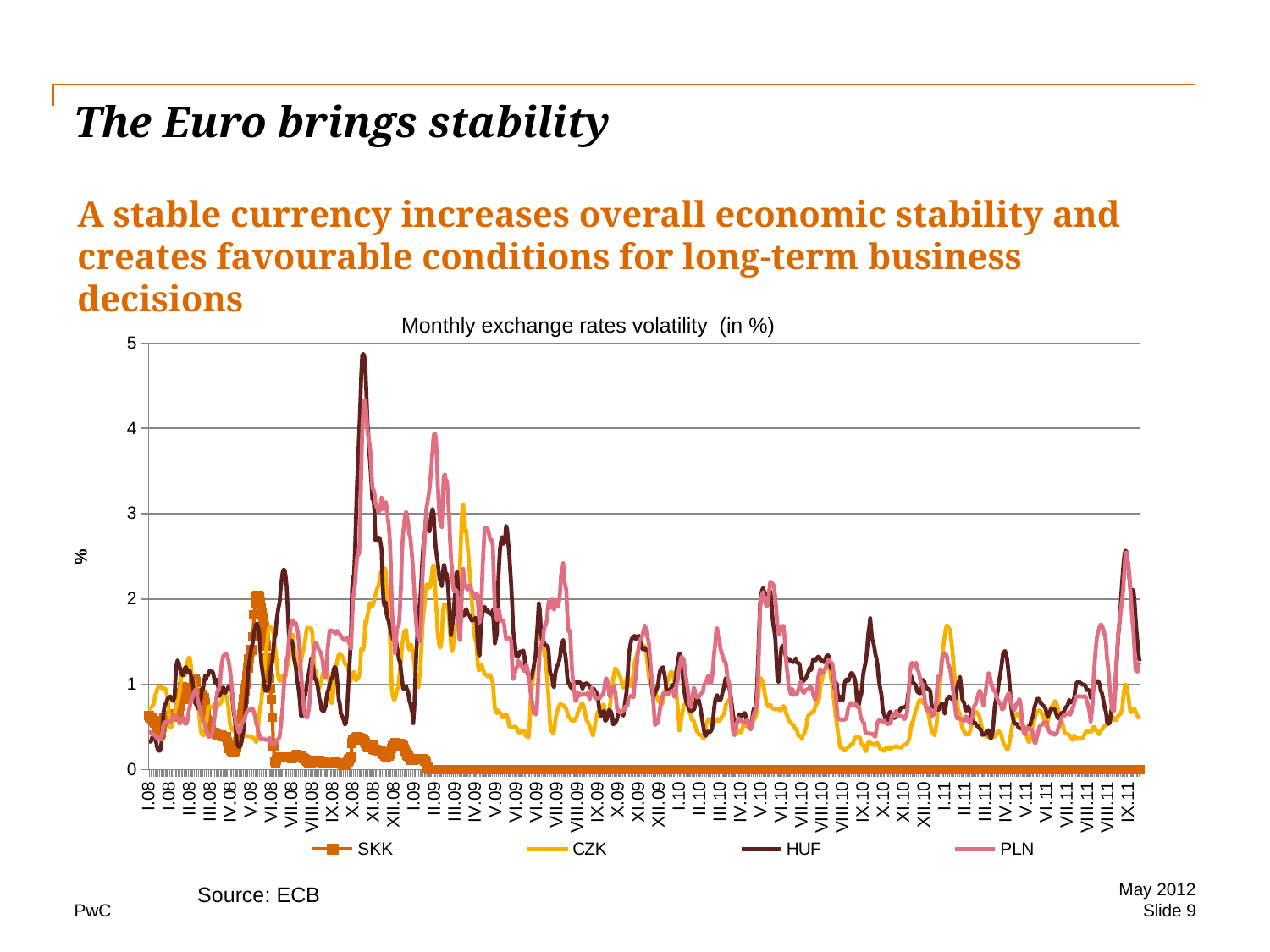
How many series does the legend list? 4 Is the highest peak of the CZK series greater or less than 4? less Which currencies are listed in the chart legend? SKK, CZK, HUF, PLN Which series reaches the highest peak on the chart? HUF Is the value of the SKK series in VI.09 greater or less than 1? less What is the highest value shown on the vertical axis? 5 Is the highest peak of the HUF series greater or less than 4? greater Around X.08, which series is higher, HUF or SKK? HUF Does the SKK series rise or fall over the course of 2008 into 2009? fall What kind of chart is shown on the slide? line chart Which series stays at zero from 2009 onwards? SKK What is the title of the chart? Monthly exchange rates volatility (in %)